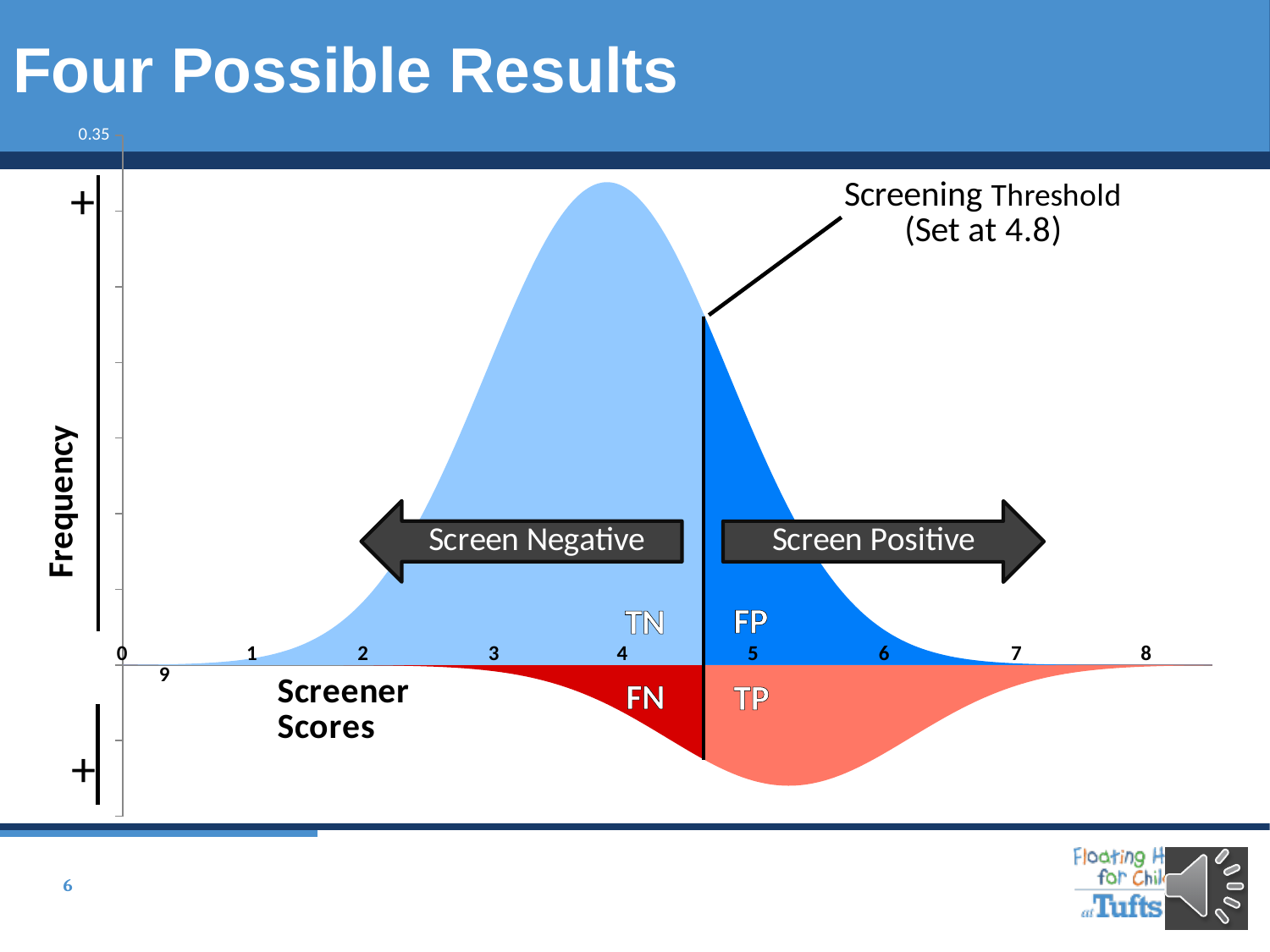
Which side of the threshold is labelled 'Screen Positive'? Right What is the title of the slide containing the chart? Four Possible Results What is the highest value printed on the vertical axis? 0.35 Which region label appears in the dark red area below the axis to the left of the threshold line? FN Is the peak of the lower (red) distribution to the left or right of the screening threshold? Right What is the label on the vertical axis? Frequency What kind of chart is shown on the slide? Area chart At what screener score is the screening threshold set? 4.8 Which region label appears in the salmon-coloured area below the axis to the right of the threshold line? TP Which region label appears in the light blue area to the left of the threshold line? TN Which region label appears in the dark blue area to the right of the threshold line? FP Is the peak of the upper (blue) distribution to the left or right of the screening threshold? Left